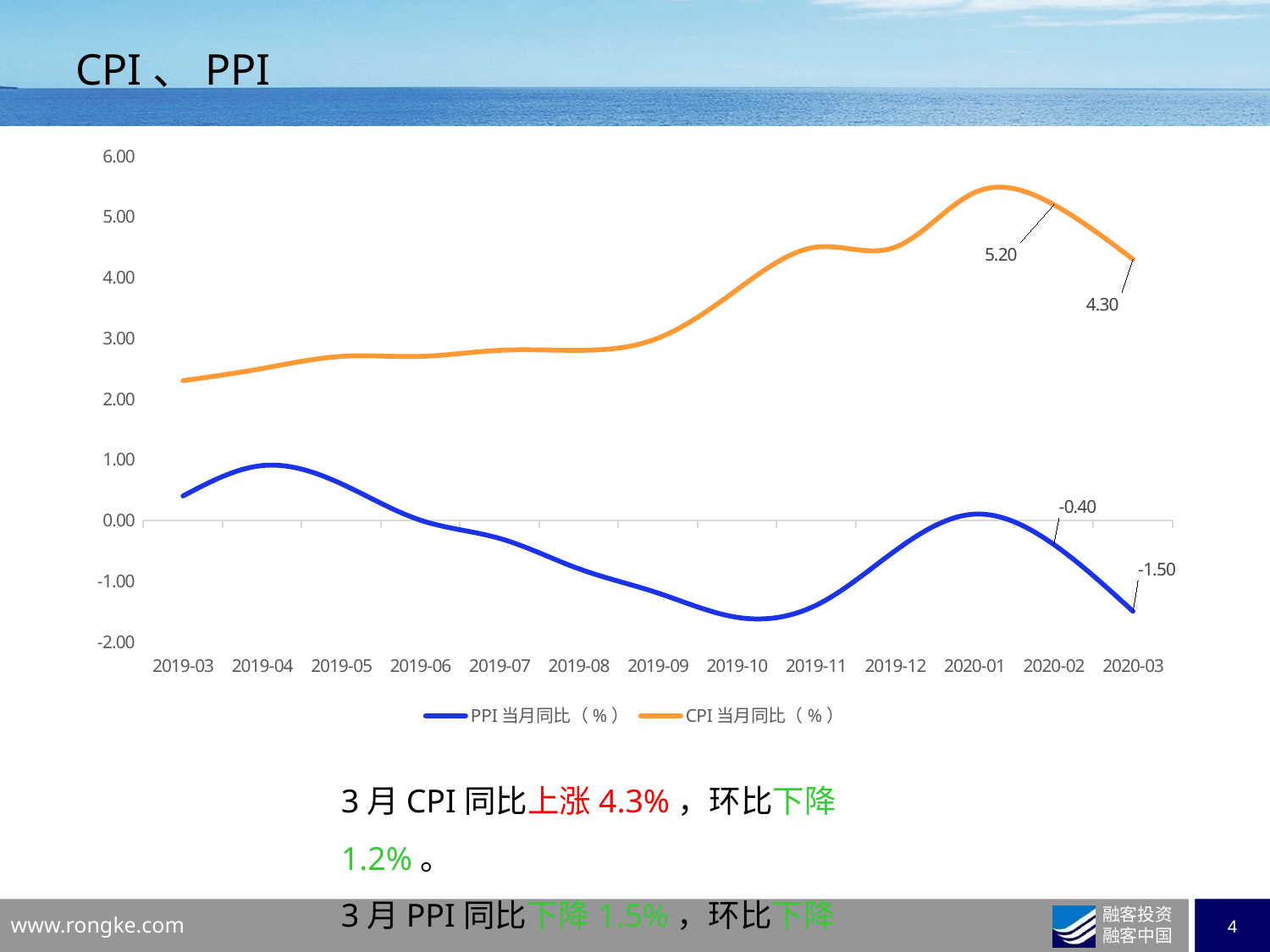
What is the value of PPI 当月同比（%） for 2020-03? -1.50 What kind of chart is shown on the slide? line chart How many months are shown on the x axis of the chart? 13 How many series does the legend list? 2 By how much did PPI 当月同比（%） fall from 2020-02 to 2020-03? 1.10 What is the value of CPI 当月同比（%） for 2020-02? 5.20 What is the value of CPI 当月同比（%） for 2020-03? 4.30 Is the value of CPI 当月同比（%） for 2019-03 greater or less than 3.00? less By how much did CPI 当月同比（%） fall from 2020-02 to 2020-03? 0.90 Which series has the larger value in 2020-03, CPI 当月同比（%） or PPI 当月同比（%）? CPI 当月同比（%） What is the value of PPI 当月同比（%） for 2020-02? -0.40 Is the value of PPI 当月同比（%） for 2019-10 greater or less than -1.00? less